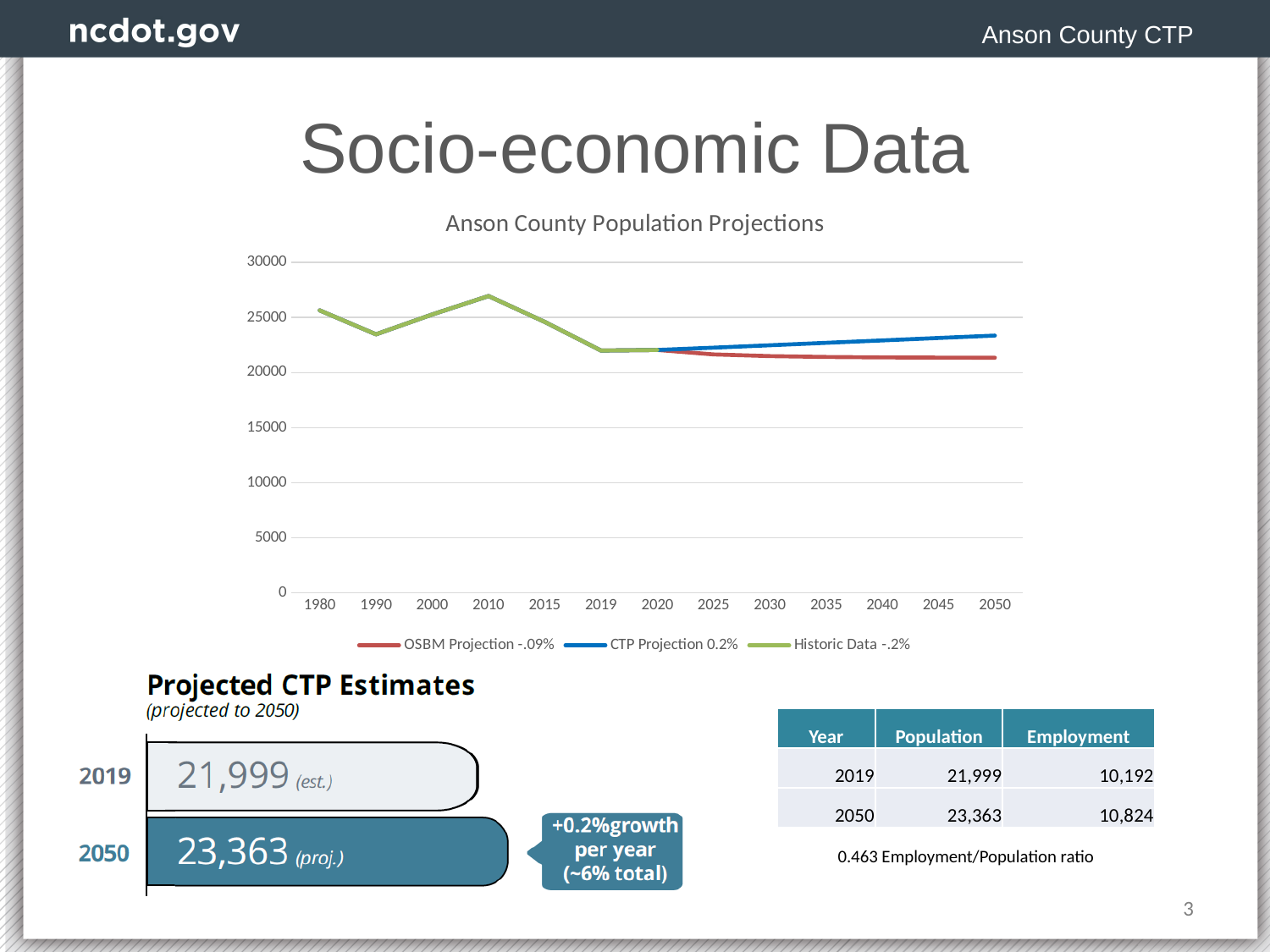
Is the Historic Data value for 1990 greater or less than 25000? less What kind of chart is shown on the slide? line chart In which year does the Historic Data series reach its highest value? 2010 How many year labels are shown along the x axis of the chart? 13 Is the Historic Data value for 2010 greater or less than 25000? greater Which series in the legend is drawn in green? Historic Data -.2% What is the title of the chart? Anson County Population Projections At 2050, which series is higher: the CTP Projection or the OSBM Projection? CTP Projection Is the OSBM Projection value for 2050 greater or less than 25000? less Does the CTP Projection series rise or fall from 2020 to 2050? rise How many series does the chart legend list? 3